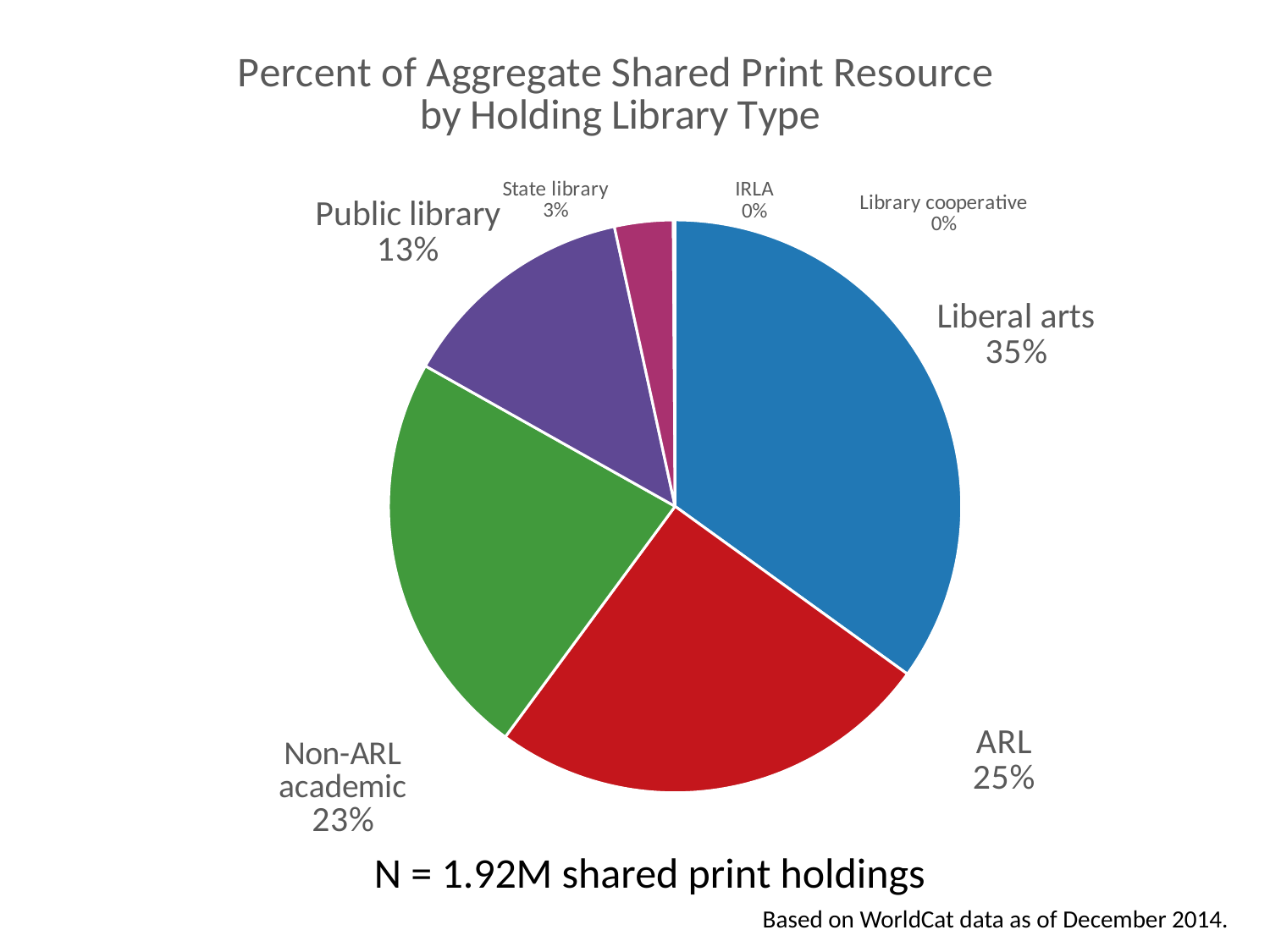
What percentage is shown for ARL? 25% Which is larger, the share for ARL or the share for Public library? ARL What type of chart is shown on the slide? pie chart What percentage is shown for Non-ARL academic? 23% What is the total number of shared print holdings (N) stated on the slide? 1.92M What percentage is shown for State library? 3% What is the title of the chart? Percent of Aggregate Shared Print Resource by Holding Library Type What percentage is shown for Public library? 13% How many holding library types are labelled on the pie chart? 7 Which holding library type has the largest share of the pie? Liberal arts What percentage of the aggregate shared print resource is held by Liberal arts libraries? 35% What is the difference in percentage points between Liberal arts and Non-ARL academic? 12